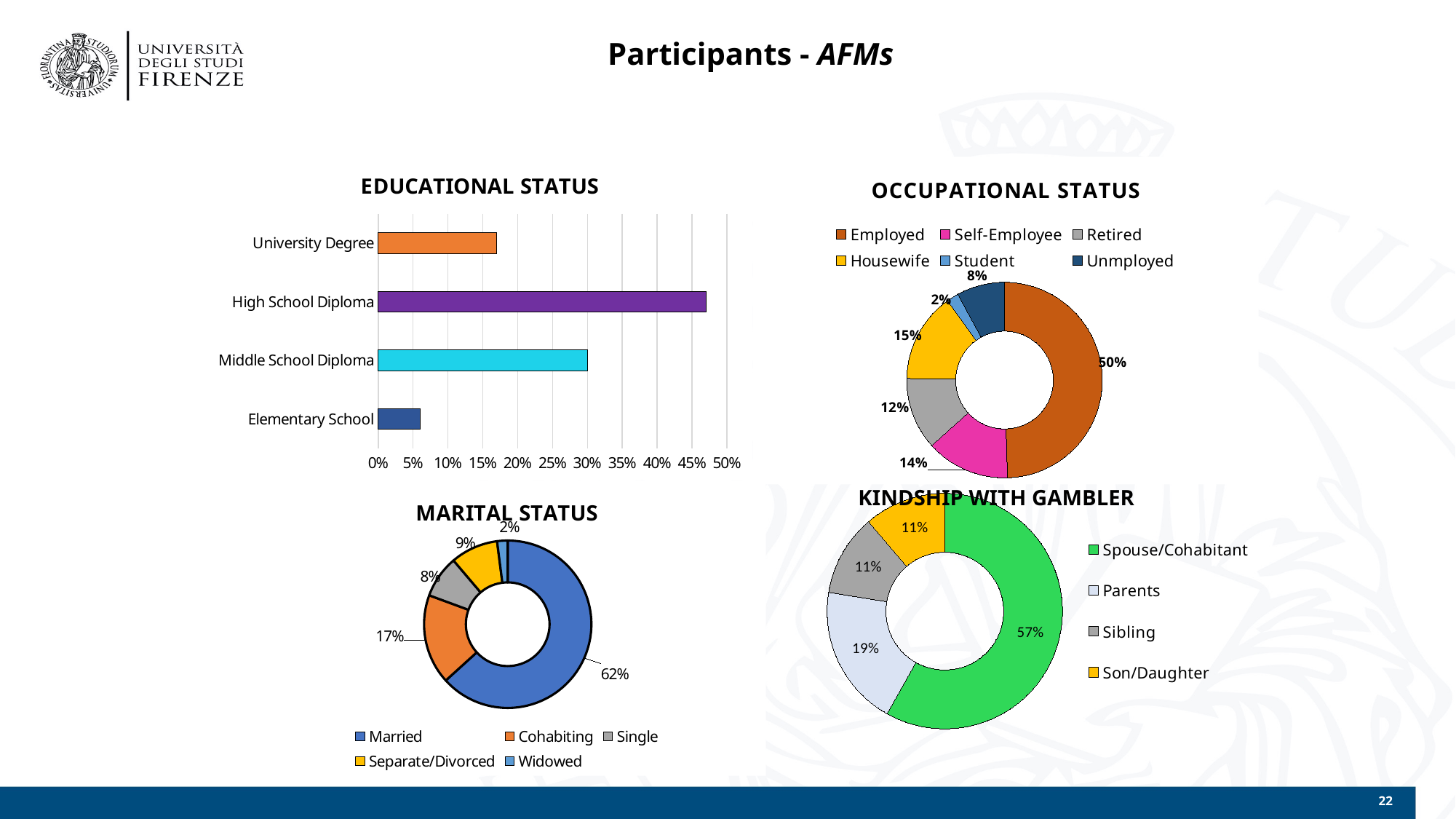
In the Educational Status chart, is the value for University Degree greater or less than 20%? less In the Marital Status chart, what is the difference between the Married and Cohabiting percentages? 45% What kind of chart is the Educational Status chart? bar chart In the Educational Status chart, which category has the lowest value? Elementary School In the Kindship with Gambler chart, what percentage is Parents? 19% In the Marital Status chart, which is larger, Single or Separate/Divorced? Separate/Divorced In the Occupational Status chart, what percentage is Employed? 50% In the Occupational Status chart, what percentage is Housewife? 15% In the Occupational Status chart, which category has the smallest share? Student In the Educational Status chart, is the value for High School Diploma greater or less than 45%? greater In the Educational Status chart, which category has the highest value? High School Diploma How many series does the legend of the Occupational Status chart list? 6